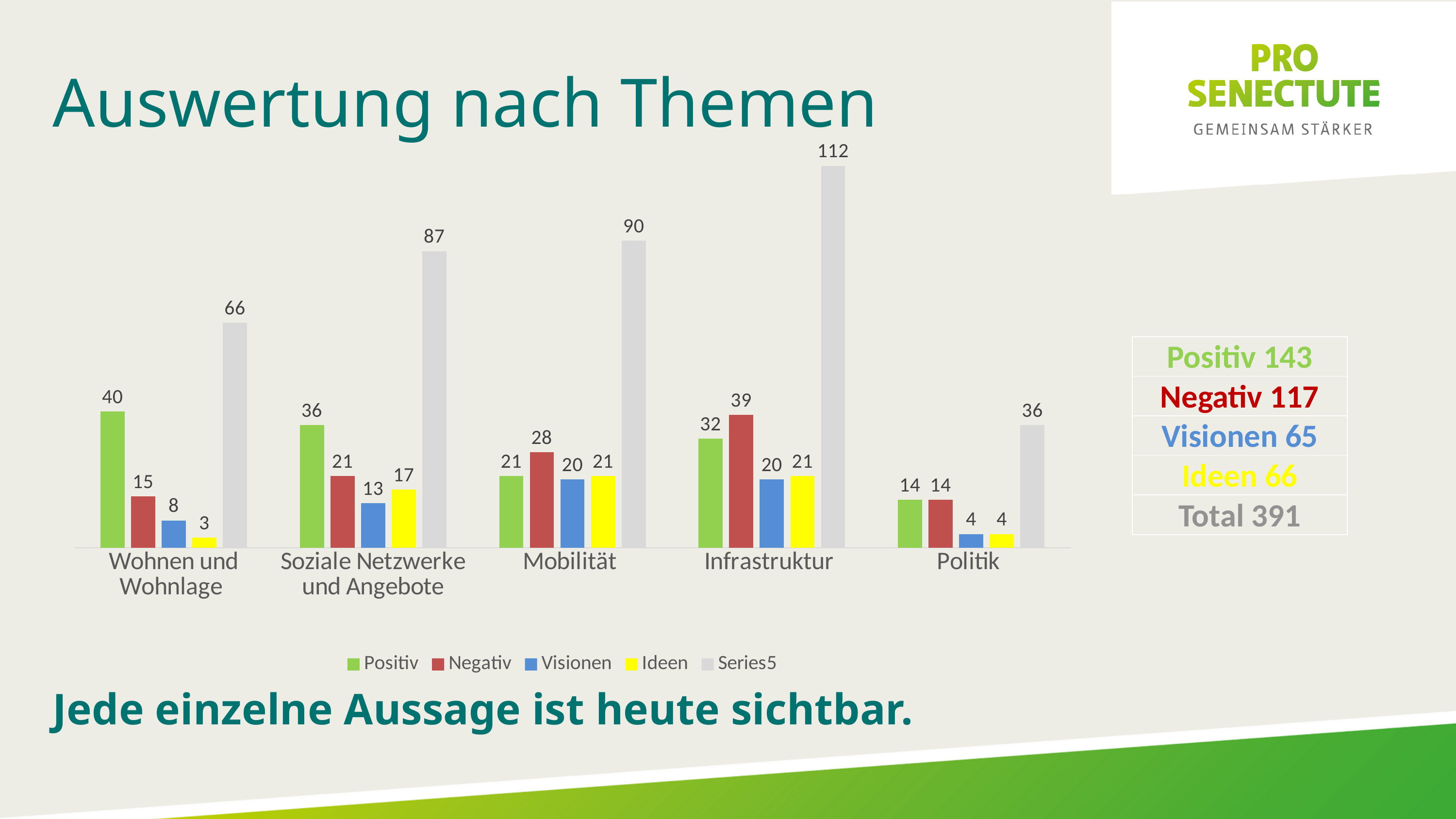
How many series does the legend list? 5 What is the difference between the Series5 values for Infrastruktur and Mobilität? 22 How many categories are shown on the x axis? 5 What colour are the Ideen bars? yellow What is the Visionen value for Soziale Netzwerke und Angebote? 13 Which category has the lowest Series5 value? Politik What is the Ideen value for Politik? 4 What kind of chart is shown on the slide? bar chart Which category has the highest Negativ value? Infrastruktur Which is larger for Mobilität, the Positiv value or the Negativ value? Negativ What is the Positiv value for Wohnen und Wohnlage? 40 What is the Series5 value for Infrastruktur? 112